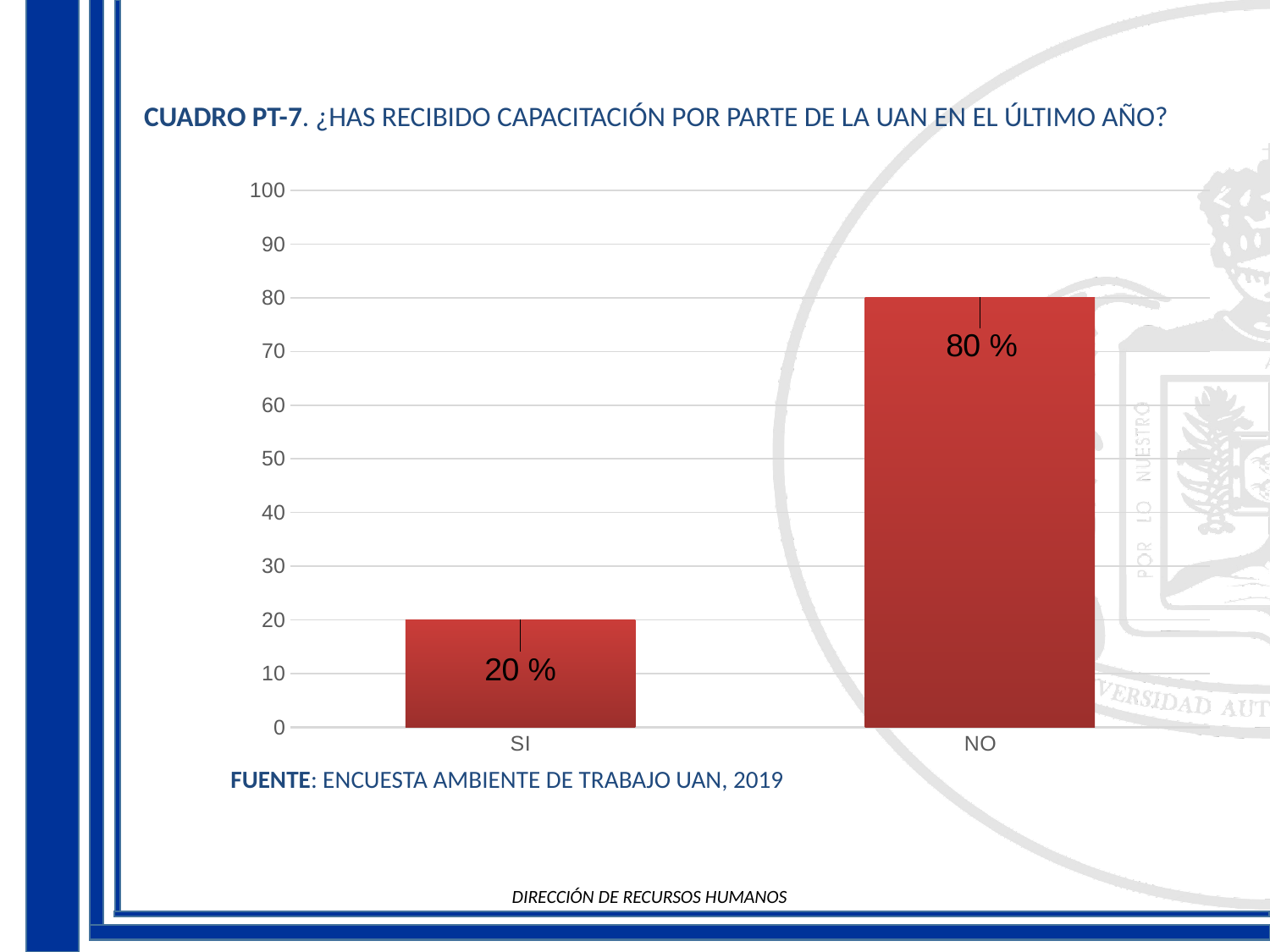
What is the value for SI? 20 % Is the value for NO greater or less than 50? greater What source is cited below the chart? ENCUESTA AMBIENTE DE TRABAJO UAN, 2019 What is the difference between the values for NO and SI? 60 % What is the maximum value shown on the y axis? 100 What is the value for NO? 80 % How many categories are shown on the x axis? 2 Is the value for SI greater or less than 30? less What kind of chart is shown on the slide? bar chart Which category has the lowest value? SI Which is larger, the value for SI or the value for NO? NO Which category has the highest value? NO